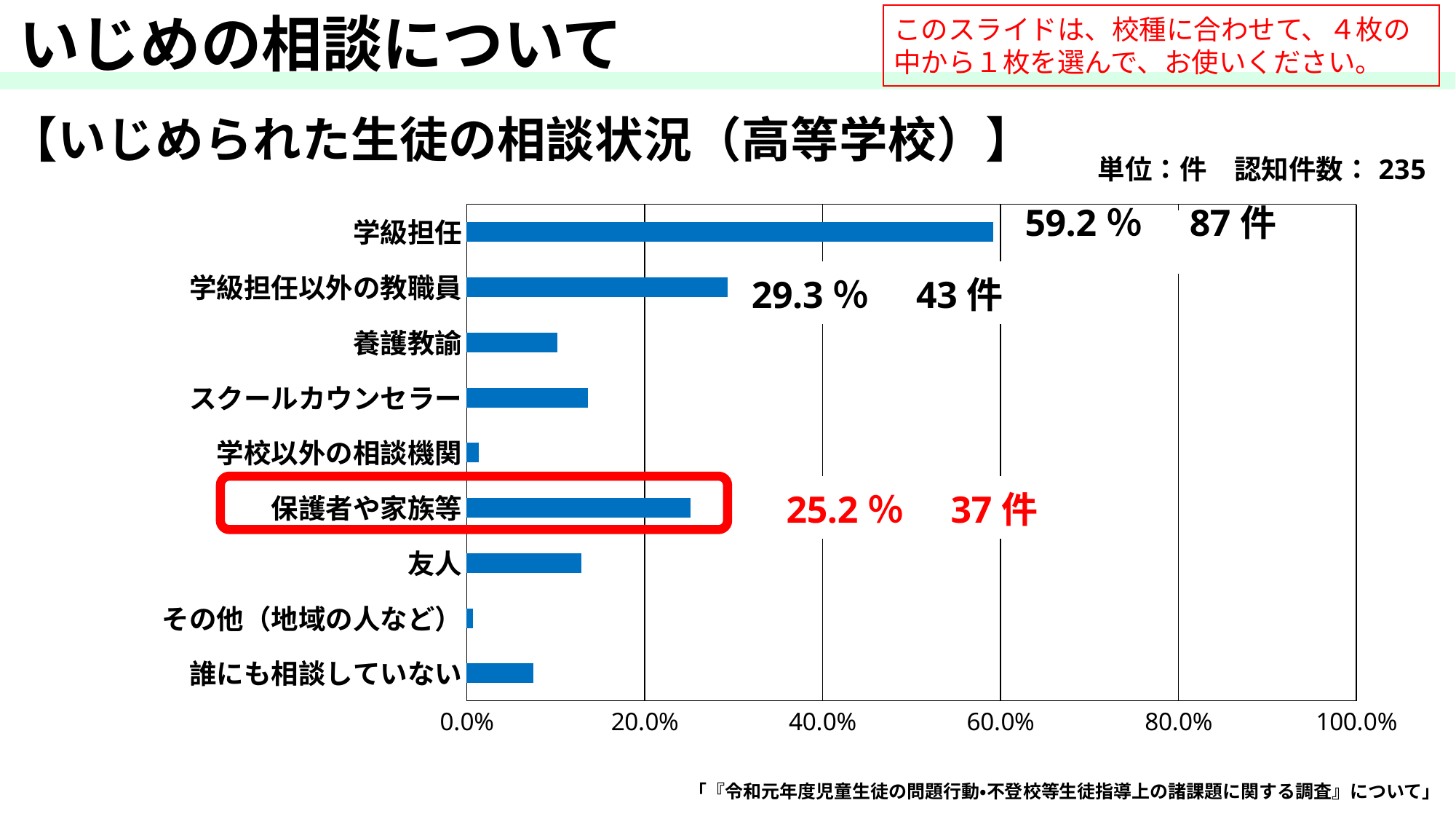
Is the value for 友人 greater or less than 20.0%? less Is the value for 学級担任 greater or less than 40.0%? greater How many categories are shown in the chart? 9 What percentage is shown for 学級担任以外の教職員? 29.3％ Which category has the highest value? 学級担任 Which is larger, the value for 学級担任以外の教職員 or for 保護者や家族等? 学級担任以外の教職員 What percentage is shown for 学級担任? 59.2％ What kind of chart is shown on the slide? bar chart How many cases (件) are shown for 学級担任? 87 件 How many more cases (件) does 学級担任以外の教職員 have than 保護者や家族等? 6 件 What is the difference in percentage points between 学級担任 and 学級担任以外の教職員? 29.9 How many cases (件) are shown for 保護者や家族等? 37 件